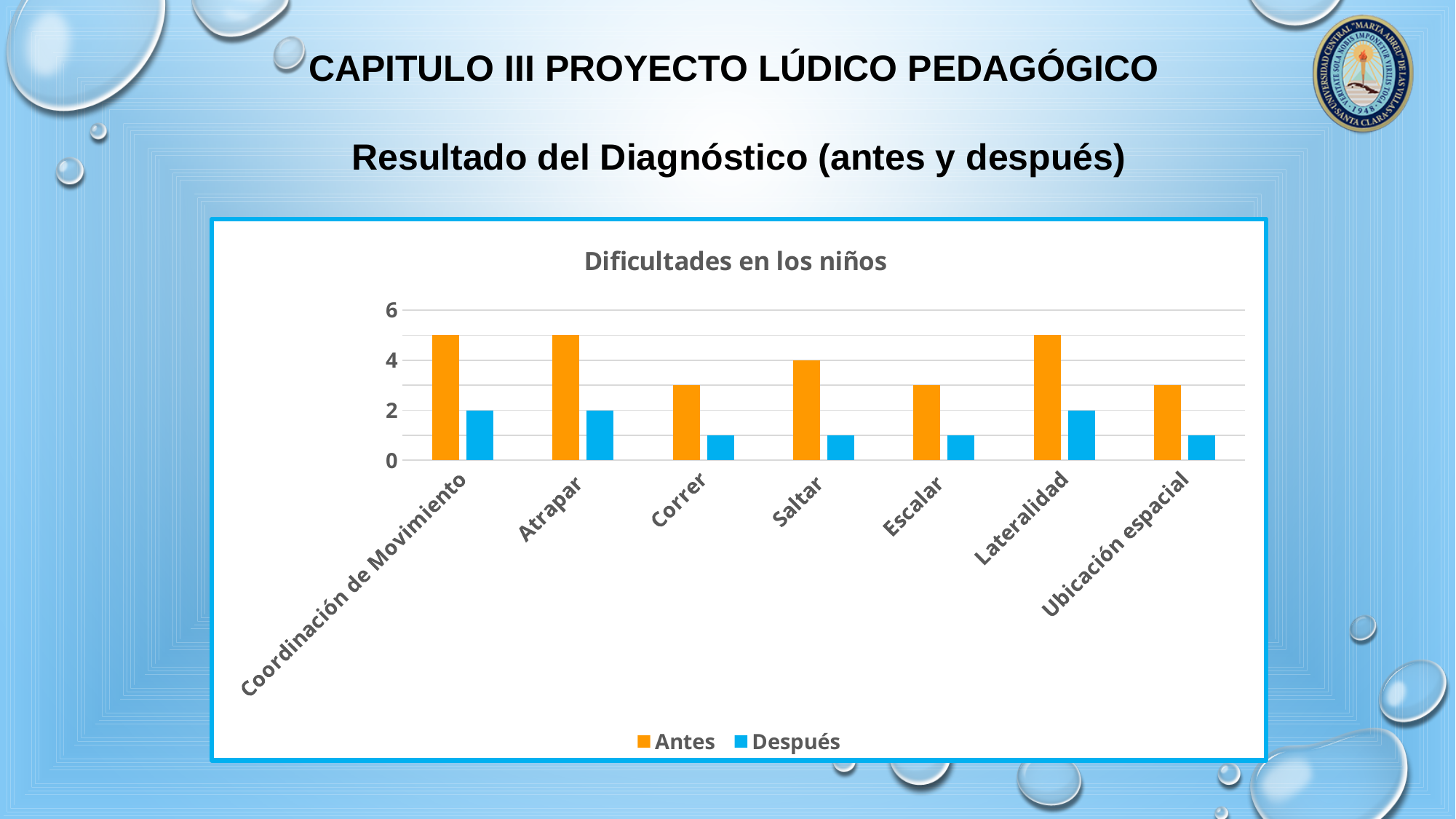
How many series does the legend list? 2 What is the Antes value for Saltar? 4 Is the Antes value for Correr greater or less than 4? less What is the title of the chart? Dificultades en los niños What is the Después value for Lateralidad? 2 How many categories are shown on the x axis? 7 What kind of chart is shown on the slide? bar chart Which series is shown in orange? Antes Is the Antes value for Lateralidad greater or less than 4? greater Which is larger for Saltar, the Antes value or the Después value? Antes Is the Después value for Escalar greater or less than 2? less What is the Después value for Atrapar? 2